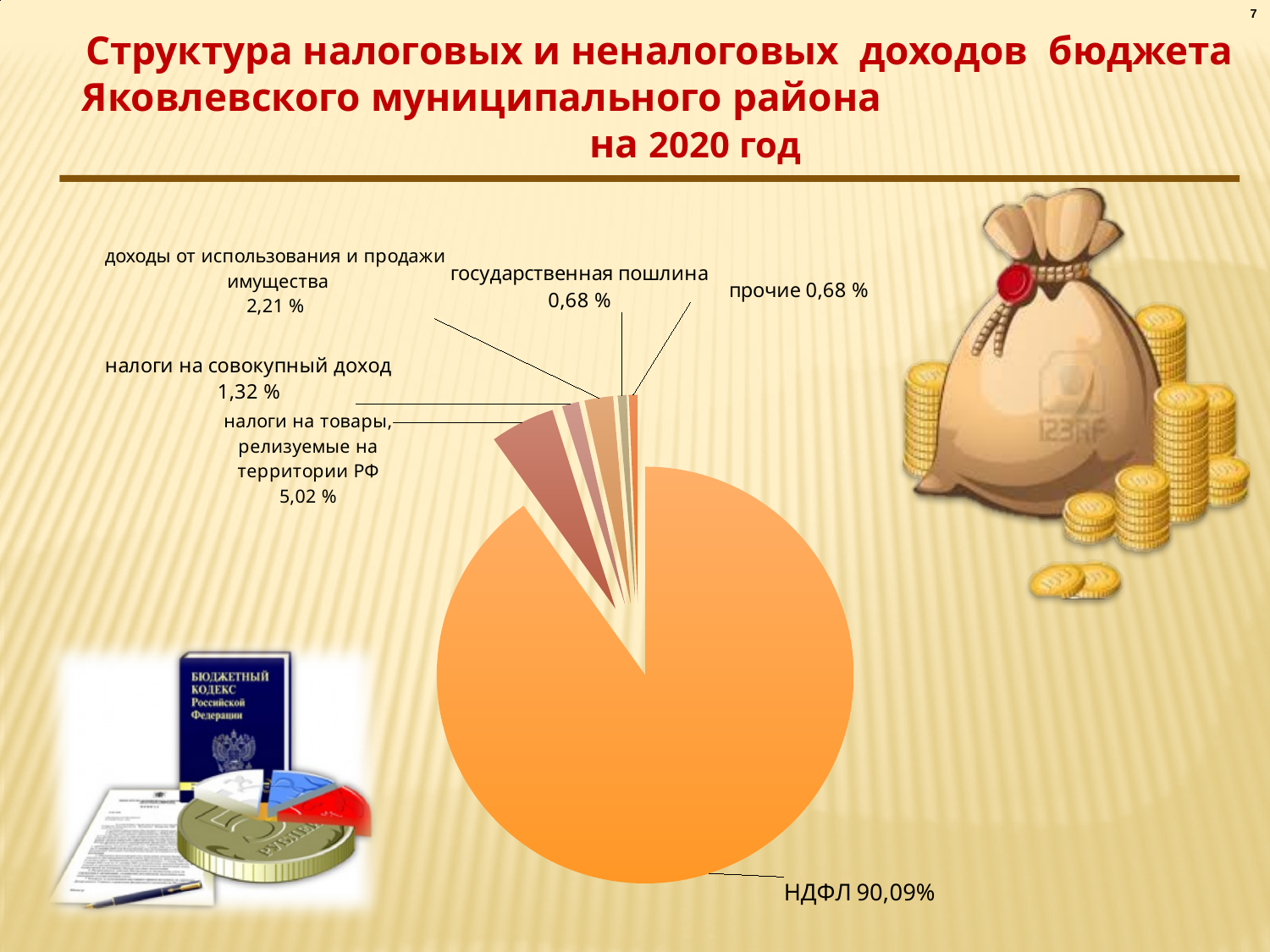
Which is larger: налоги на товары, реализуемые на территории РФ or доходы от использования и продажи имущества? налоги на товары, реализуемые на территории РФ Which category has the largest slice of the pie? НДФЛ What is the value shown for налоги на товары, реализуемые на территории РФ? 5,02 % What is the value shown for государственная пошлина? 0,68 % What is the value shown for налоги на совокупный доход? 1,32 % What is the difference between the shares of доходы от использования и продажи имущества and прочие? 1,53 % How many slices does the pie chart have? 6 What is the difference between the shares of налоги на товары, реализуемые на территории РФ and налоги на совокупный доход? 3,70 % What is the value shown for доходы от использования и продажи имущества? 2,21 % What share of the pie does НДФЛ have? 90,09% What kind of chart is shown on the slide? pie chart Which year does the chart title say the budget structure refers to? 2020